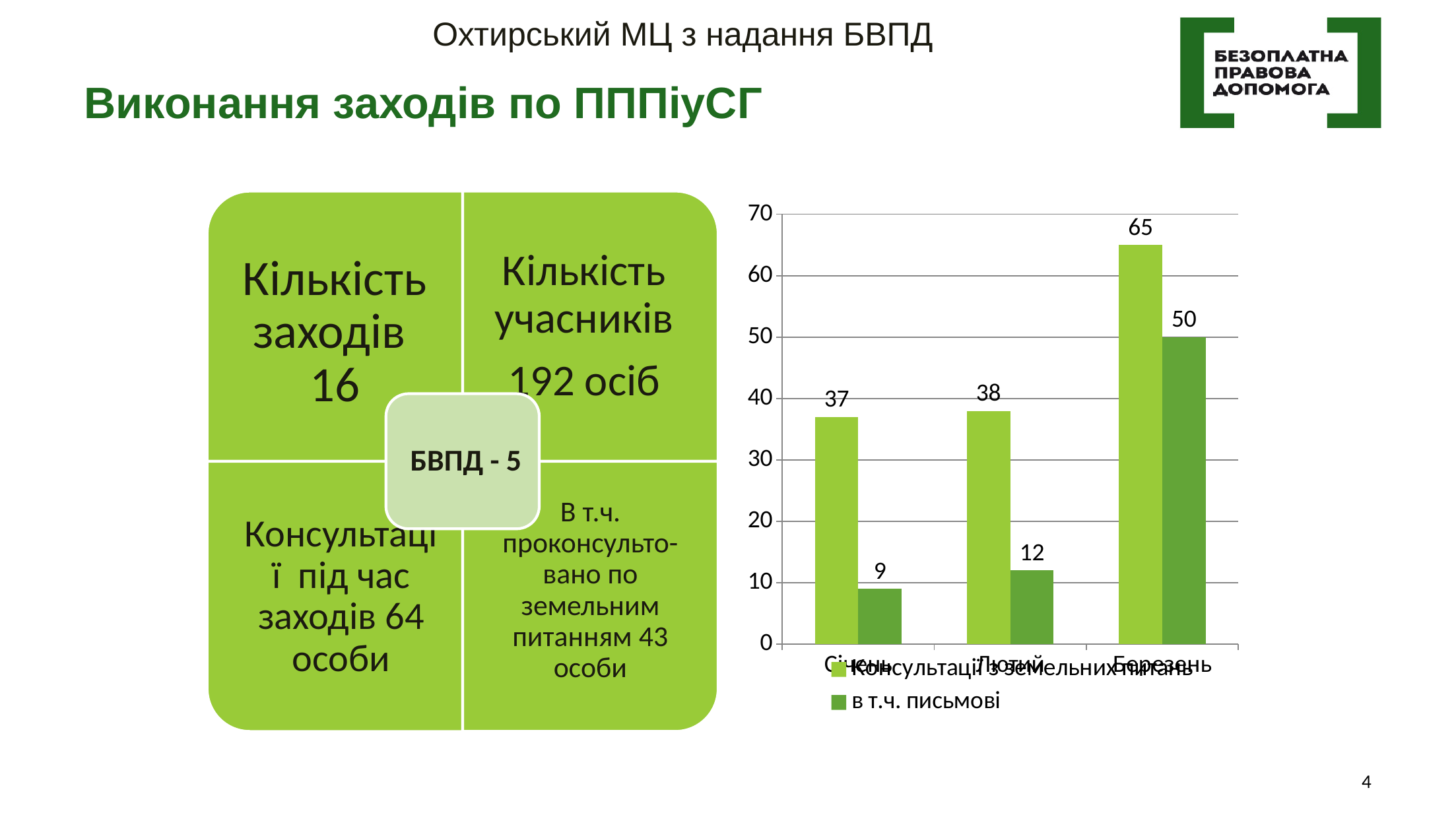
Which month has the lowest value for в т.ч. письмові? Січень What is the value for в т.ч. письмові in Лютий? 12 How many series does the chart legend list? 2 What is the difference between Консультації з земельних питань and в т.ч. письмові in Березень? 15 Which month has the highest value for Консультації з земельних питань? Березень Which is larger: в т.ч. письмові in Березень or Консультації з земельних питань in Лютий? в т.ч. письмові in Березень What is the value for в т.ч. письмові in Січень? 9 What is the value for Консультації з земельних питань in Березень? 65 What is the difference between the в т.ч. письмові values for Березень and Лютий? 38 How many months are shown on the x axis of the chart? 3 Is the value for Консультації з земельних питань in Січень greater or less than 40? less What kind of chart is shown on the slide? bar chart